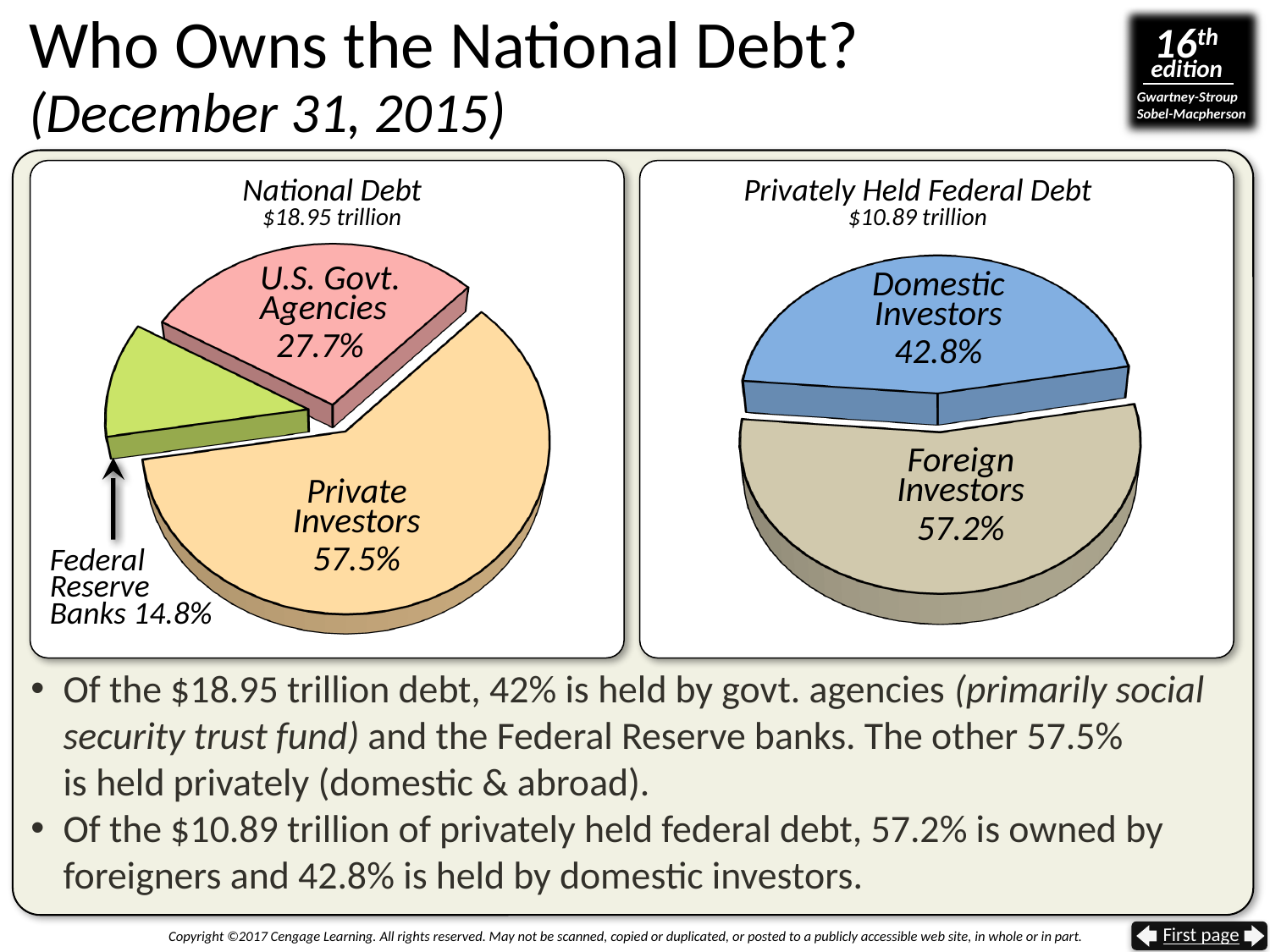
In the National Debt pie chart, which slice is the largest? Private Investors In the National Debt pie chart, what is the difference between the U.S. Govt. Agencies share and the Federal Reserve Banks share? 12.9% What total amount is shown under the title of the Privately Held Federal Debt chart? $10.89 trillion In the Privately Held Federal Debt pie chart, what share is held by Foreign Investors? 57.2% In the Privately Held Federal Debt pie chart, what share is held by Domestic Investors? 42.8% In the National Debt pie chart, what share is held by Federal Reserve Banks? 14.8% In the National Debt pie chart, what share is held by U.S. Govt. Agencies? 27.7% In the National Debt pie chart, what share is held by Private Investors? 57.5% In the Privately Held Federal Debt pie chart, which is larger, Domestic Investors or Foreign Investors? Foreign Investors In the National Debt pie chart, how many slices are there? 3 In the National Debt pie chart, which slice is the smallest? Federal Reserve Banks What type of chart is used on the left side of the slide? Pie chart